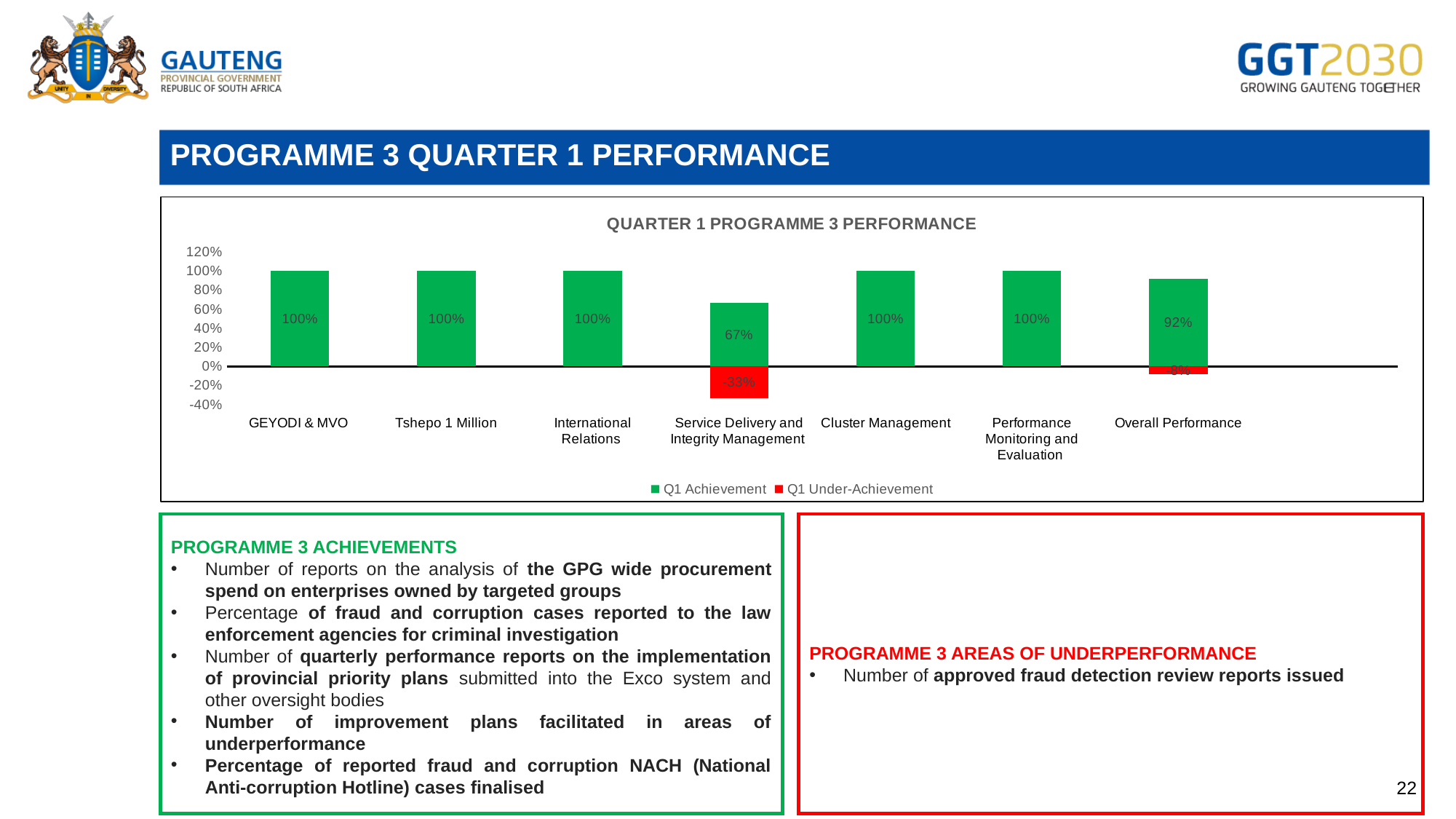
Which category has the lowest Q1 Achievement value? Service Delivery and Integrity Management What is the Q1 Achievement value for Cluster Management? 100% What kind of chart is shown on the slide? Bar chart What is the title of the chart? QUARTER 1 PROGRAMME 3 PERFORMANCE What is the Q1 Achievement value for Overall Performance? 92% What is the Q1 Under-Achievement value for Service Delivery and Integrity Management? -33% Which has a higher Q1 Achievement value, Overall Performance or Service Delivery and Integrity Management? Overall Performance How many series does the chart legend list? 2 How many categories have a Q1 Achievement value of 100%? 5 How many categories are shown on the x axis of the chart? 7 What is the Q1 Achievement value for Service Delivery and Integrity Management? 67% What is the difference between the Q1 Achievement values for GEYODI & MVO and Service Delivery and Integrity Management? 33%